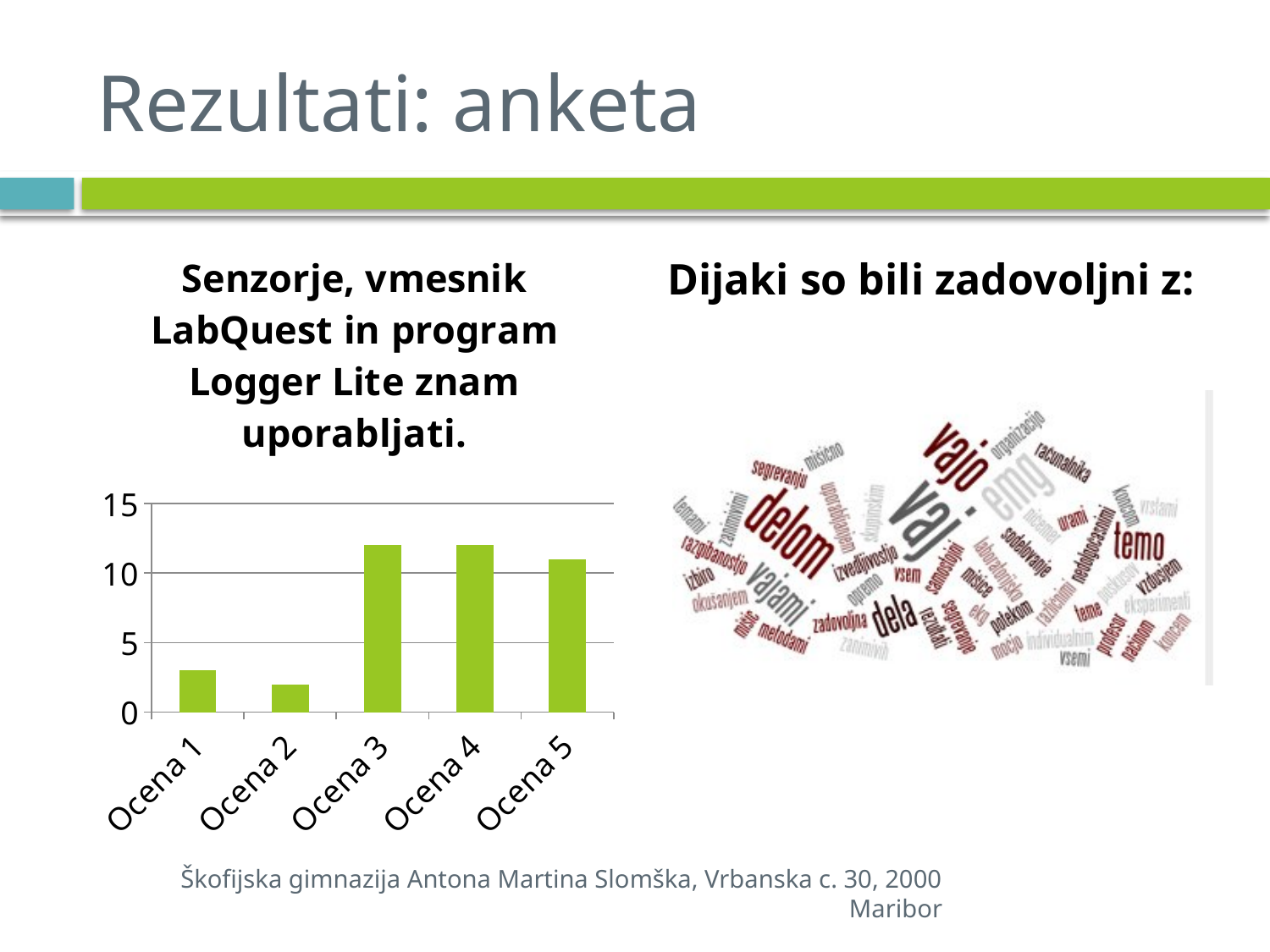
What colour are the bars in the chart? green Is the value for Ocena 5 greater or less than 10? greater Which category has the lowest value in the bar chart? Ocena 2 Is the value for Ocena 1 greater or less than 5? less Is the value for Ocena 3 greater or less than 10? greater What is the title of the bar chart? Senzorje, vmesnik LabQuest in program Logger Lite znam uporabljati. What kind of chart is shown on the slide? bar chart Which is larger, the value for Ocena 2 or the value for Ocena 5? Ocena 5 Which is larger, the value for Ocena 3 or the value for Ocena 1? Ocena 3 How many categories are shown on the x axis of the bar chart? 5